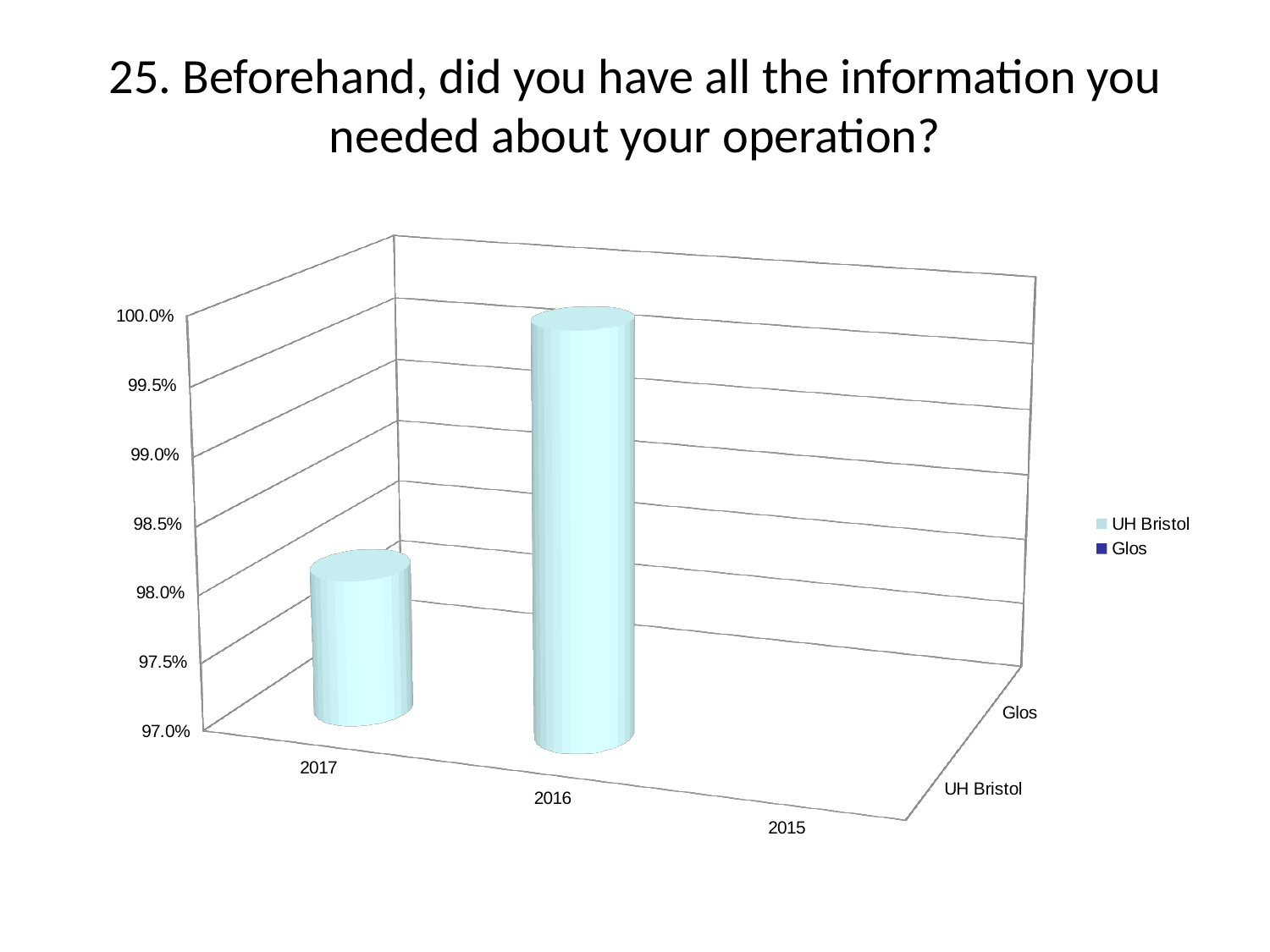
What is the lowest value shown on the vertical axis? 97.0% What kind of chart is shown on the slide? bar chart Which is larger, the UH Bristol value for 2016 or for 2017? 2016 Is the UH Bristol value for 2017 greater or less than 99.0%? less Is the UH Bristol value for 2016 greater or less than 99.0%? greater Which series are listed in the legend? UH Bristol and Glos How many series does the legend list? 2 How many year categories are shown along the x axis? 3 Which year has the highest UH Bristol value? 2016 What is the title of the chart? 25. Beforehand, did you have all the information you needed about your operation?